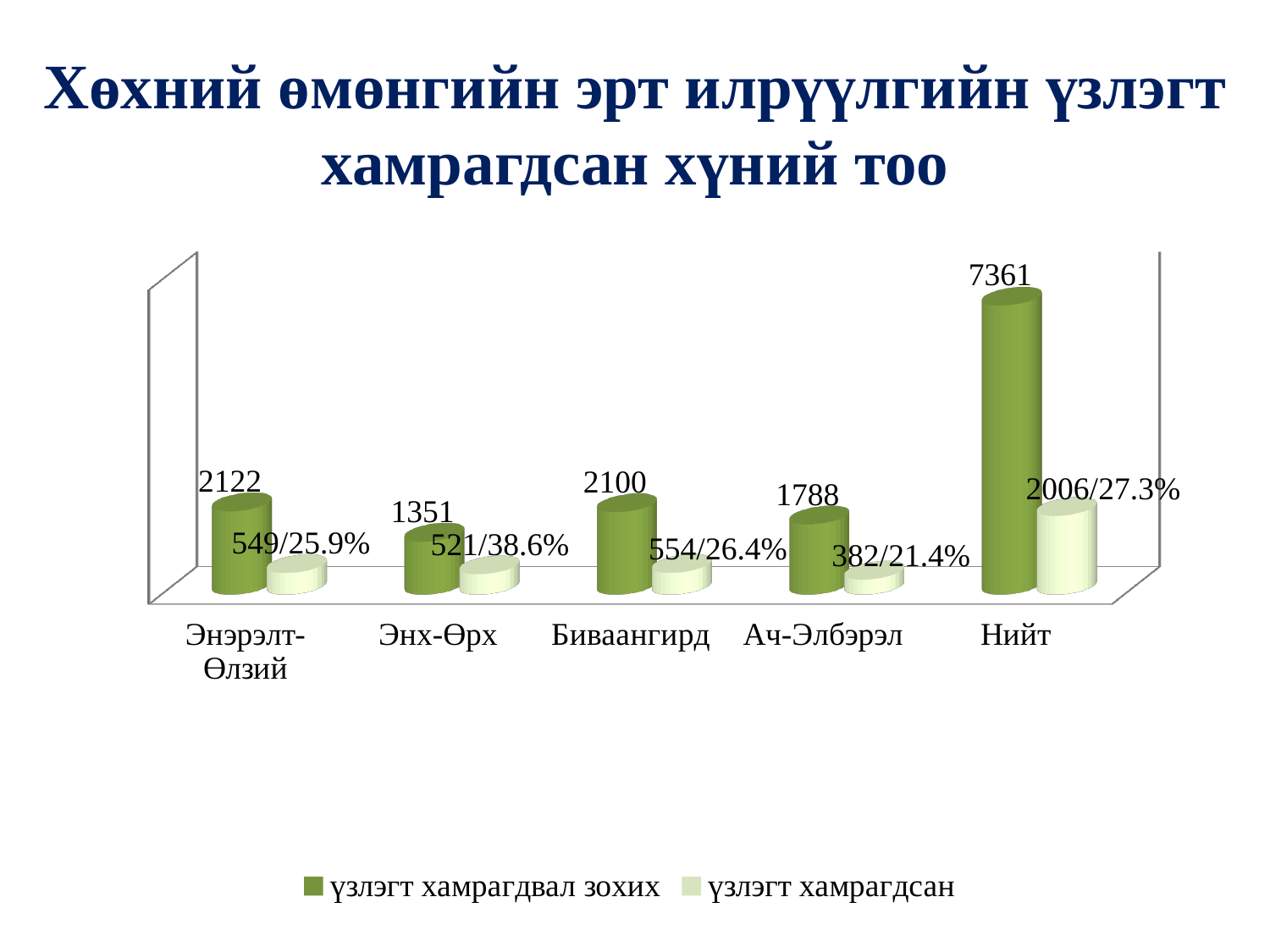
Which category has the highest value in the үзлэгт хамрагдвал зохих series? Нийт What is the value for Энх-Өрх in the үзлэгт хамрагдвал зохих series? 1351 How many series does the legend list? 2 What data label is shown for Ач-Элбэрэл in the үзлэгт хамрагдсан series? 382/21.4% How many categories are shown on the x axis? 5 What kind of chart is shown on the slide? Bar chart What data label is shown for Энэрэлт-Өлзий in the үзлэгт хамрагдсан series? 549/25.9% Which is larger in the үзлэгт хамрагдвал зохих series: Биваангирд or Ач-Элбэрэл? Биваангирд What is the name of the second series in the legend? үзлэгт хамрагдсан What is the value for Нийт in the үзлэгт хамрагдвал зохих series? 7361 Excluding Нийт, which category has the lowest value in the үзлэгт хамрагдвал зохих series? Энх-Өрх What is the difference between the үзлэгт хамрагдвал зохих values for Энэрэлт-Өлзий and Энх-Өрх? 771